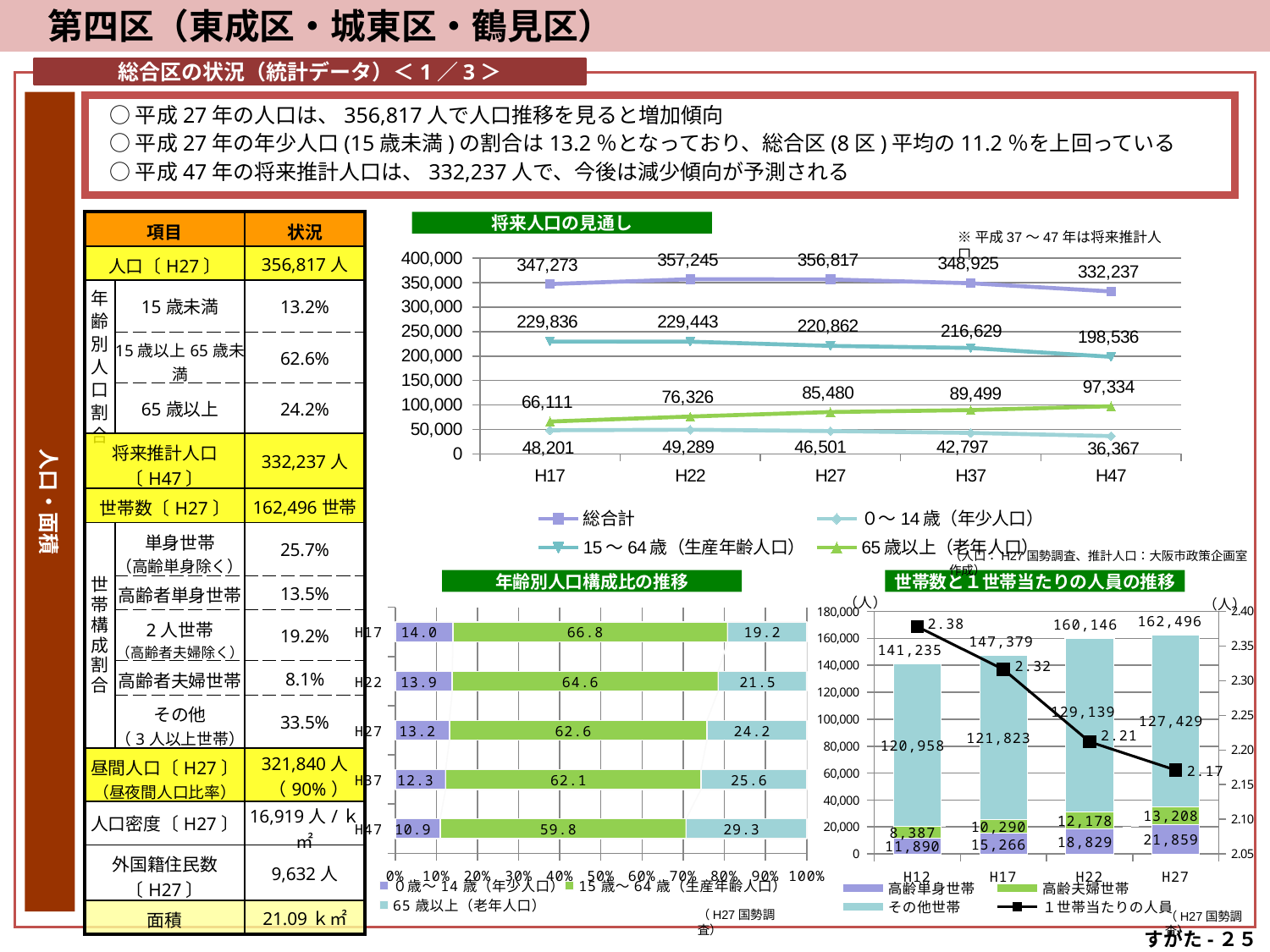
In the 年齢別人口構成比の推移 chart, which year has the highest value for 65歳以上（老年人口）? H47 In the 将来人口の見通し chart, does the 65歳以上（老年人口） series rise or fall from H17 to H47? rise In the 将来人口の見通し chart, what is the value of 総合計 for H22? 357,245 What kind of chart is the 年齢別人口構成比の推移 chart? stacked bar chart In the 将来人口の見通し chart, which year has the lowest value for 0～14歳（年少人口）? H47 In the 年齢別人口構成比の推移 chart, what is the share of 15歳～64歳（生産年齢人口） for H27? 62.6 In the 世帯数と１世帯当たりの人員の推移 chart, which is larger: その他世帯 for H22 or for H27? H22 How many series does the legend of the 将来人口の見通し chart list? 4 In the 将来人口の見通し chart, what is the difference between the 15～64歳（生産年齢人口） values for H17 and H47? 31,300 In the 世帯数と１世帯当たりの人員の推移 chart, what is the value of 高齢単身世帯 for H27? 21,859 In the 世帯数と１世帯当たりの人員の推移 chart, what is the value of １世帯当たりの人員 for H12? 2.38 In the 将来人口の見通し chart, what is the value of 65歳以上（老年人口） for H47? 97,334